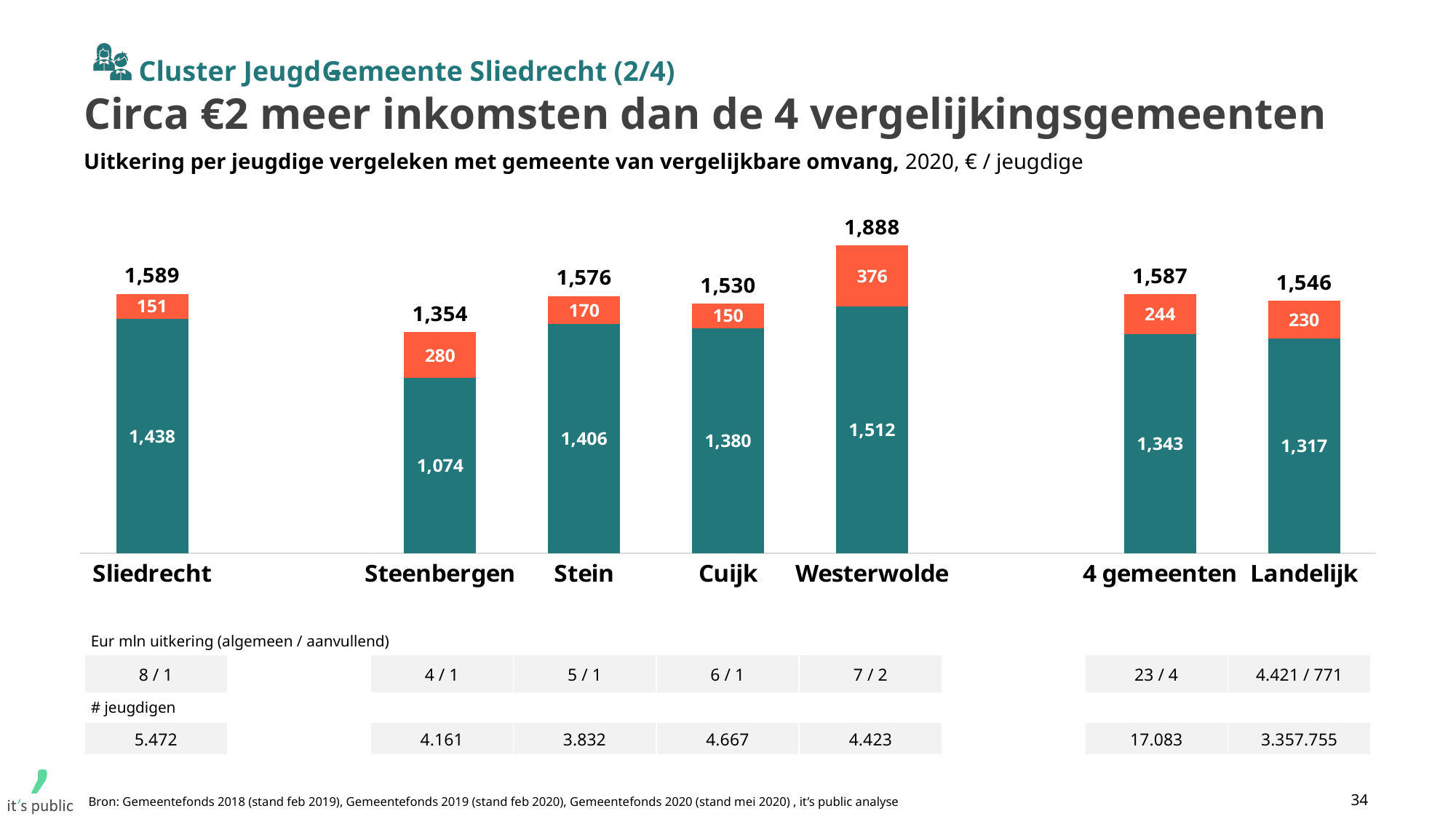
Which category has the lowest total value? Steenbergen What is the value of the teal (bottom) segment for Steenbergen? 1,074 How many categories (bars) are shown on the chart? 7 What is the difference between the orange segment for Steenbergen and the orange segment for Cuijk? 130 Which category has the highest total value? Westerwolde What is the total of the stacked bar for Landelijk? 1,546 What kind of chart is shown on the slide? Stacked bar chart What is the total value printed above the bar for Sliedrecht? 1,589 What is the value of the orange (top) segment for Westerwolde? 376 What is the difference between the total for Westerwolde and the total for Sliedrecht? 299 What is the value of the teal (bottom) segment for 4 gemeenten? 1,343 Which is larger: the total for Stein or the total for Cuijk? Stein